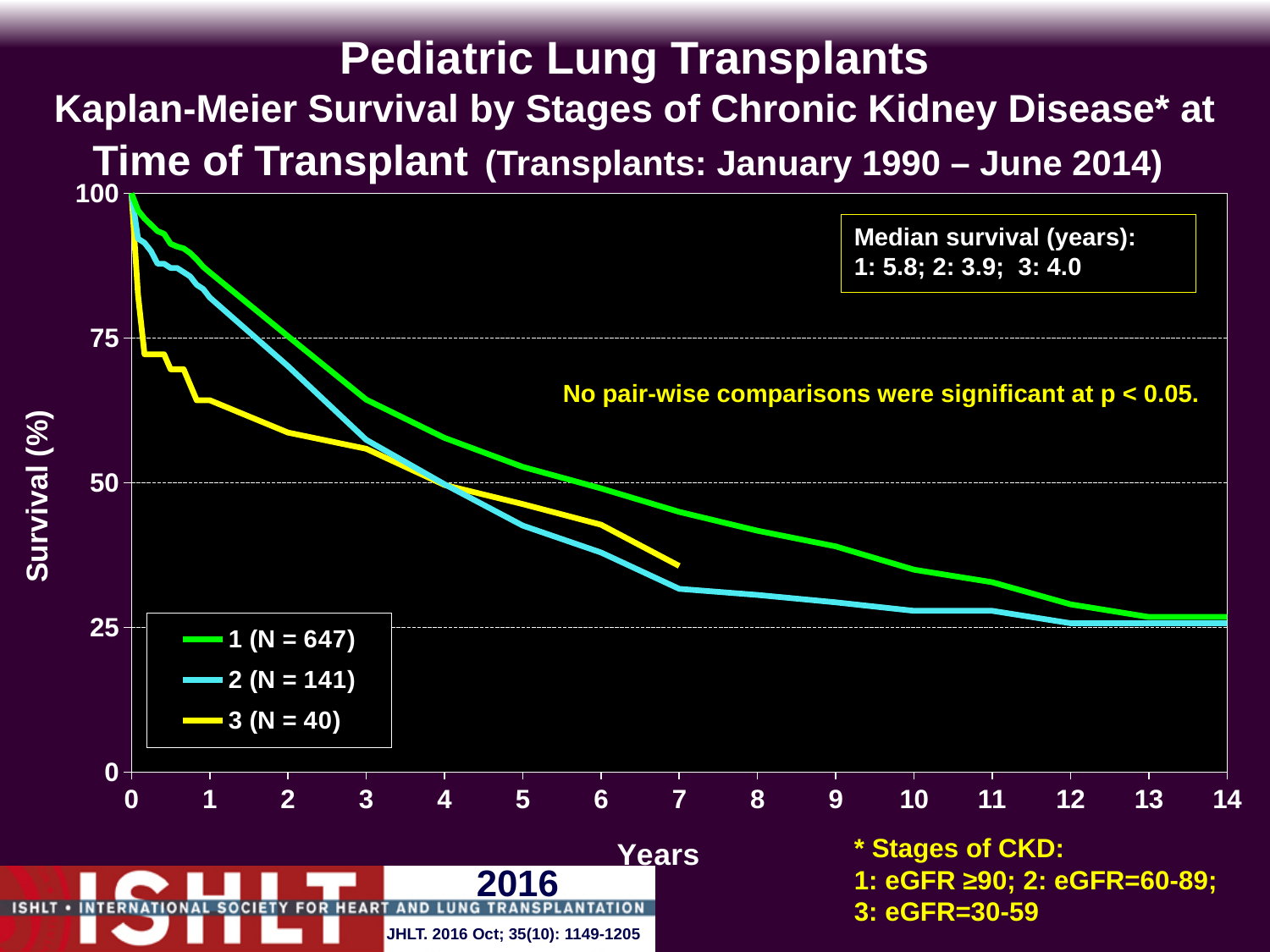
What is the median survival in years for group 2? 3.9 Which group has the highest median survival? 1 What is the difference in median survival (years) between group 1 and group 2? 1.9 What is the N for group 3 in the legend? 40 Do the survival curves rise or fall as years increase? Fall Is the survival value for group 1 at year 10 greater or less than 25? greater At year 1, which group has higher survival, group 1 or group 3? Group 1 What is the label on the y axis? Survival (%) Which group has the lowest median survival? 2 How many series does the legend list? 3 What is the N for group 1 in the legend? 647 What kind of chart is shown on the slide? Line chart